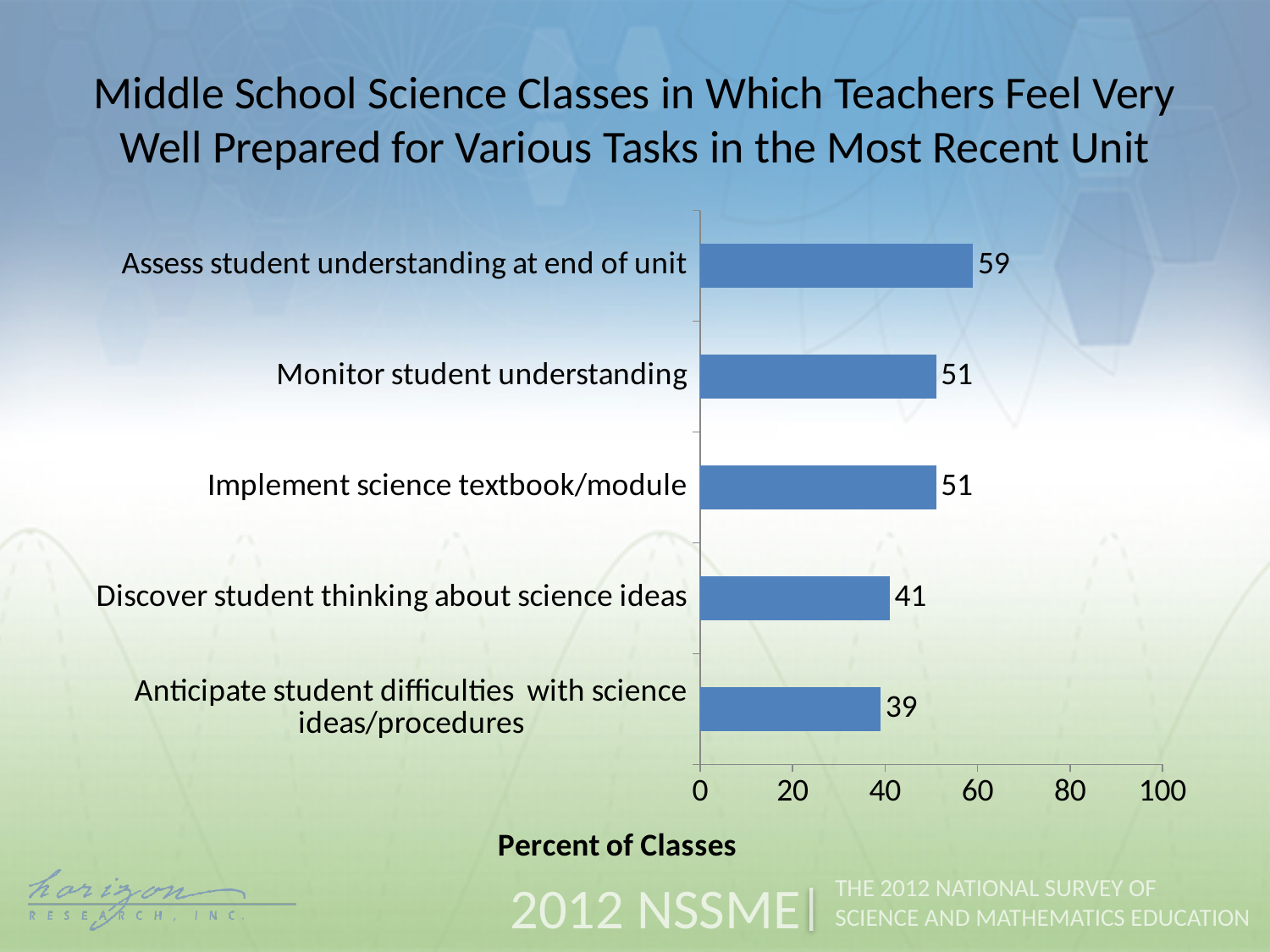
What is the value for "Anticipate student difficulties with science ideas/procedures"? 39 How many categories are shown in the chart? 5 Which is larger: the value for "Implement science textbook/module" or the value for "Discover student thinking about science ideas"? Implement science textbook/module What is the label of the horizontal axis? Percent of Classes Which category has the highest value? Assess student understanding at end of unit What is the difference between the values for "Assess student understanding at end of unit" and "Anticipate student difficulties with science ideas/procedures"? 20 What kind of chart is shown on the slide? Bar chart Which category has the lowest value? Anticipate student difficulties with science ideas/procedures What is the value for "Assess student understanding at end of unit"? 59 What is the value for "Monitor student understanding"? 51 Is the value for "Monitor student understanding" greater or less than 40? greater What is the value for "Discover student thinking about science ideas"? 41